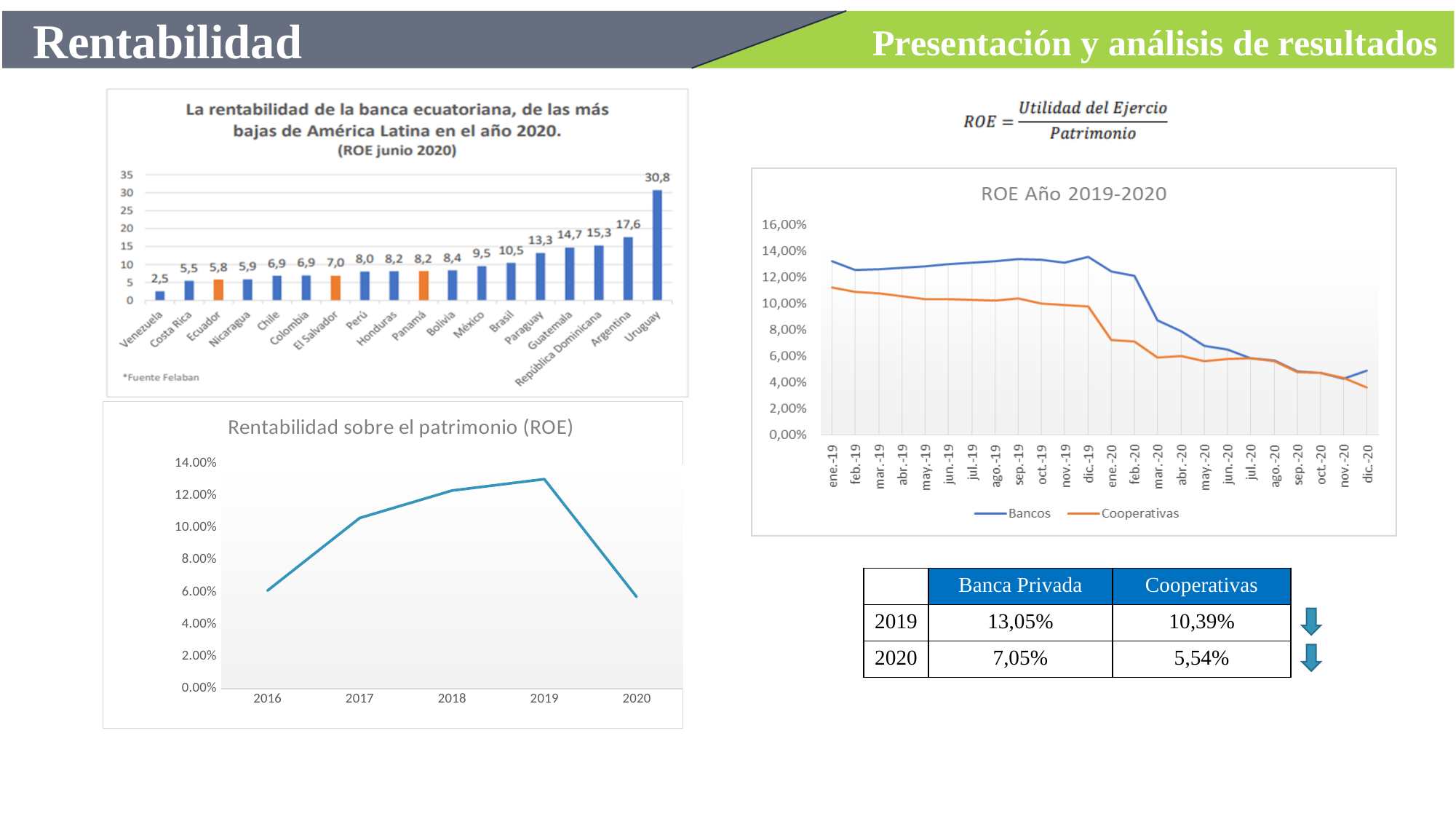
In the top-left bar chart (ROE junio 2020), what is the difference between Argentina and Ecuador? 11,8 In the right chart 'ROE Año 2019-2020', how many series does the legend list? 2 In the top-left bar chart (ROE junio 2020), what is the value for Ecuador? 5,8 In the bottom-left chart 'Rentabilidad sobre el patrimonio (ROE)', how many years are plotted? 5 In the top-left bar chart (ROE junio 2020), how many countries are shown? 18 In the top-left bar chart (ROE junio 2020), which country has the highest value? Uruguay In the bottom-left chart 'Rentabilidad sobre el patrimonio (ROE)', is the value for 2019 greater or less than 12.00%? greater In the top-left bar chart (ROE junio 2020), which is larger, the value for Brasil or the value for México? Brasil In the bottom-left chart 'Rentabilidad sobre el patrimonio (ROE)', what kind of chart is it? Line chart In the right chart 'ROE Año 2019-2020', does the Cooperativas line generally rise or fall from ene.-19 to dic.-20? Fall In the top-left bar chart (ROE junio 2020), which country has the lowest value? Venezuela In the top-left bar chart (ROE junio 2020), what is the value for Uruguay? 30,8